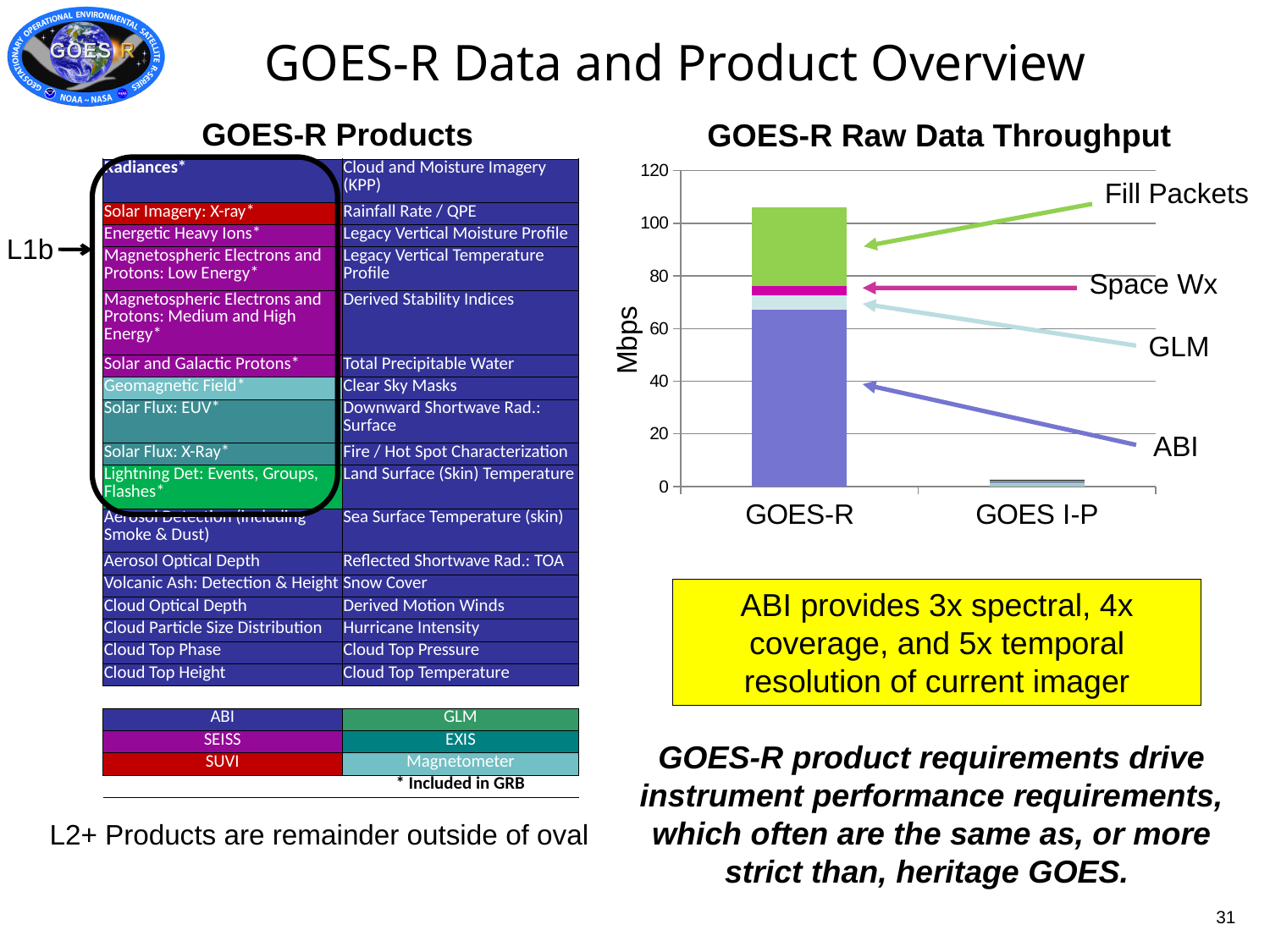
Which has the larger total throughput in the GOES-R Raw Data Throughput chart, GOES-R or GOES I-P? GOES-R What unit is shown on the y-axis of the GOES-R Raw Data Throughput chart? Mbps Which category has the lowest total throughput in the GOES-R Raw Data Throughput chart? GOES I-P In the GOES-R Raw Data Throughput chart, is the total value for GOES I-P greater or less than 20 Mbps? less How many categories are shown on the x-axis of the GOES-R Raw Data Throughput chart? 2 What is the title of the chart on the right side of the slide? GOES-R Raw Data Throughput In the GOES-R Raw Data Throughput chart, is the ABI segment of the GOES-R bar greater or less than 80 Mbps? less Which category has the highest total throughput in the GOES-R Raw Data Throughput chart? GOES-R What type of chart is the GOES-R Raw Data Throughput chart? Stacked bar chart Which segment contributes the most to the GOES-R bar in the GOES-R Raw Data Throughput chart? ABI In the GOES-R Raw Data Throughput chart, is the ABI segment of the GOES-R bar greater or less than 60 Mbps? greater